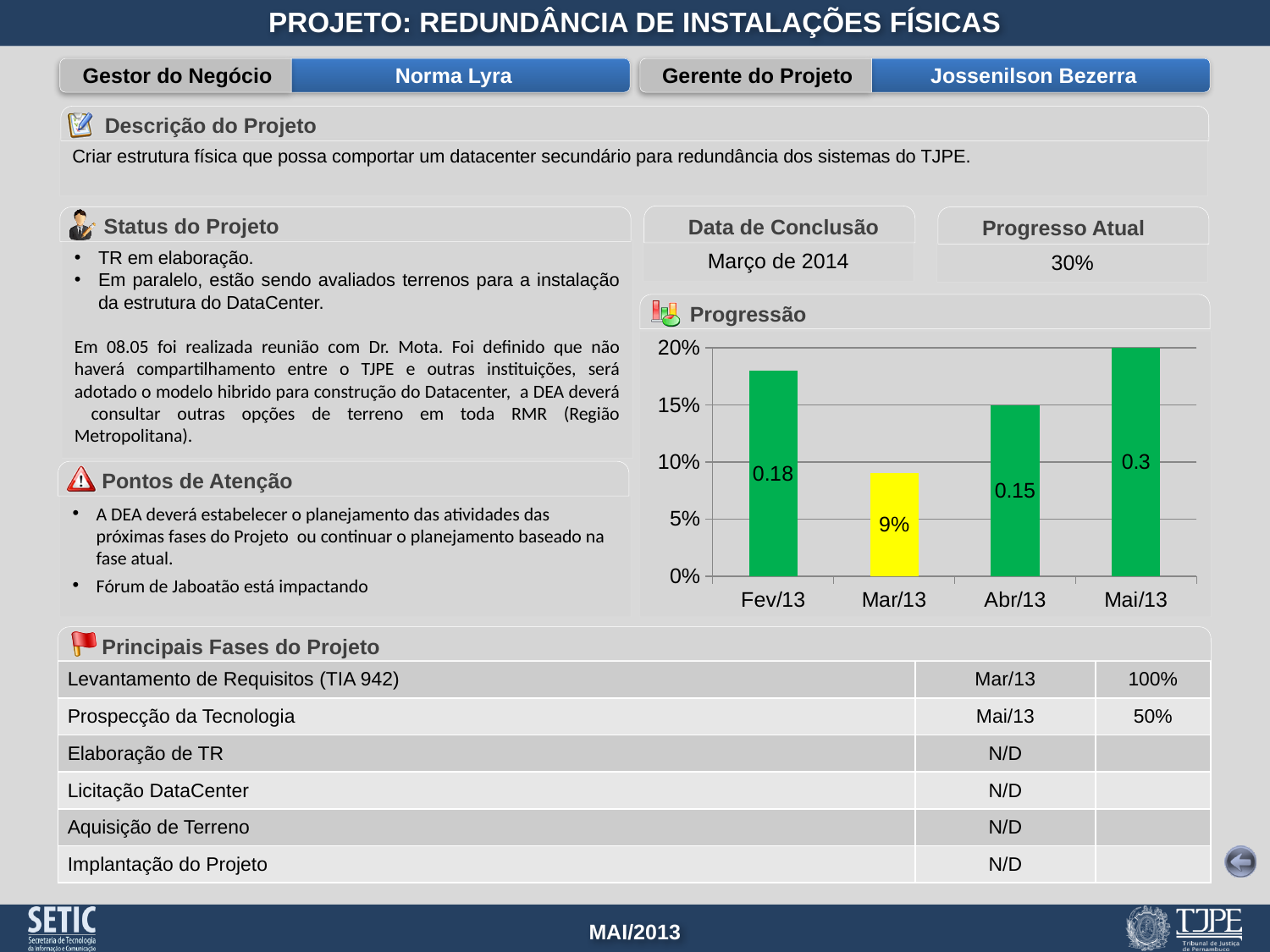
What is the data label shown on the Abr/13 bar in the Progressão chart? 0.15 What is the data label shown on the Mai/13 bar in the Progressão chart? 0.3 In the Progressão chart, what is the difference between the labelled values for Fev/13 and Abr/13? 0.03 In the Progressão chart, which bar is taller: Fev/13 or Abr/13? Fev/13 Which month has the tallest bar in the Progressão chart? Mai/13 Which month has the shortest bar in the Progressão chart? Mar/13 How many months are shown on the x axis of the Progressão chart? 4 What is the data label shown on the Fev/13 bar in the Progressão chart? 0.18 What type of chart is the Progressão chart? bar chart In the Progressão chart, is the bar for Mar/13 greater or less than 10%? less What is the data label shown on the Mar/13 bar in the Progressão chart? 9% What colour is the Mar/13 bar in the Progressão chart? yellow